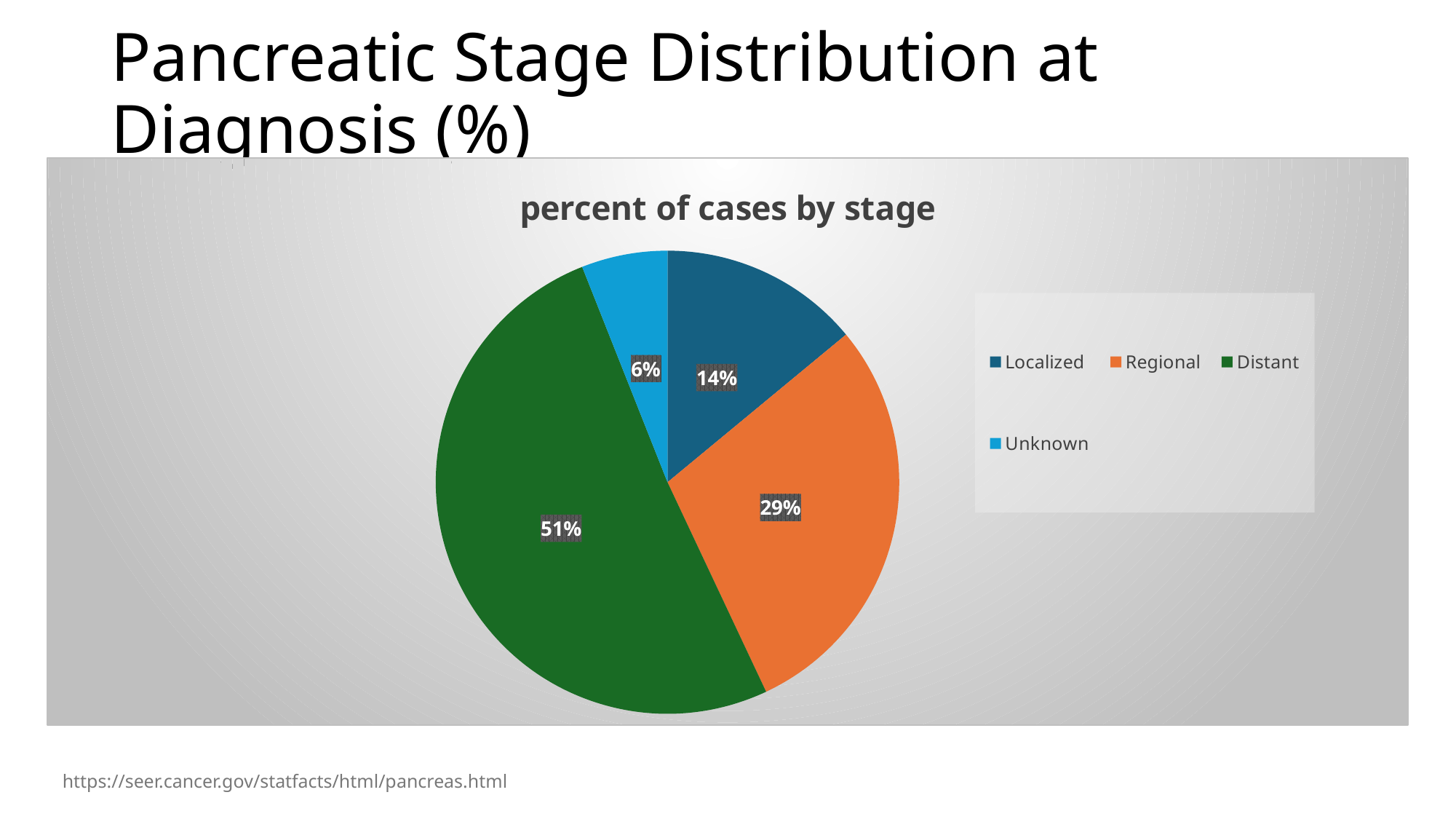
What percentage of cases are Regional stage? 29% What kind of chart is shown on the slide? Pie chart Which stage has the smallest share of cases? Unknown What colour is the Distant slice? Green How many stage categories are shown in the pie chart? 4 Which stage has the largest share of cases? Distant Which is larger, the share for Localized or the share for Regional? Regional What is the difference in percentage points between Distant and Regional? 22 What is the title of the chart? percent of cases by stage What percentage of cases are Unknown stage? 6% What percentage of cases are Localized stage? 14% What percentage of cases are Distant stage? 51%